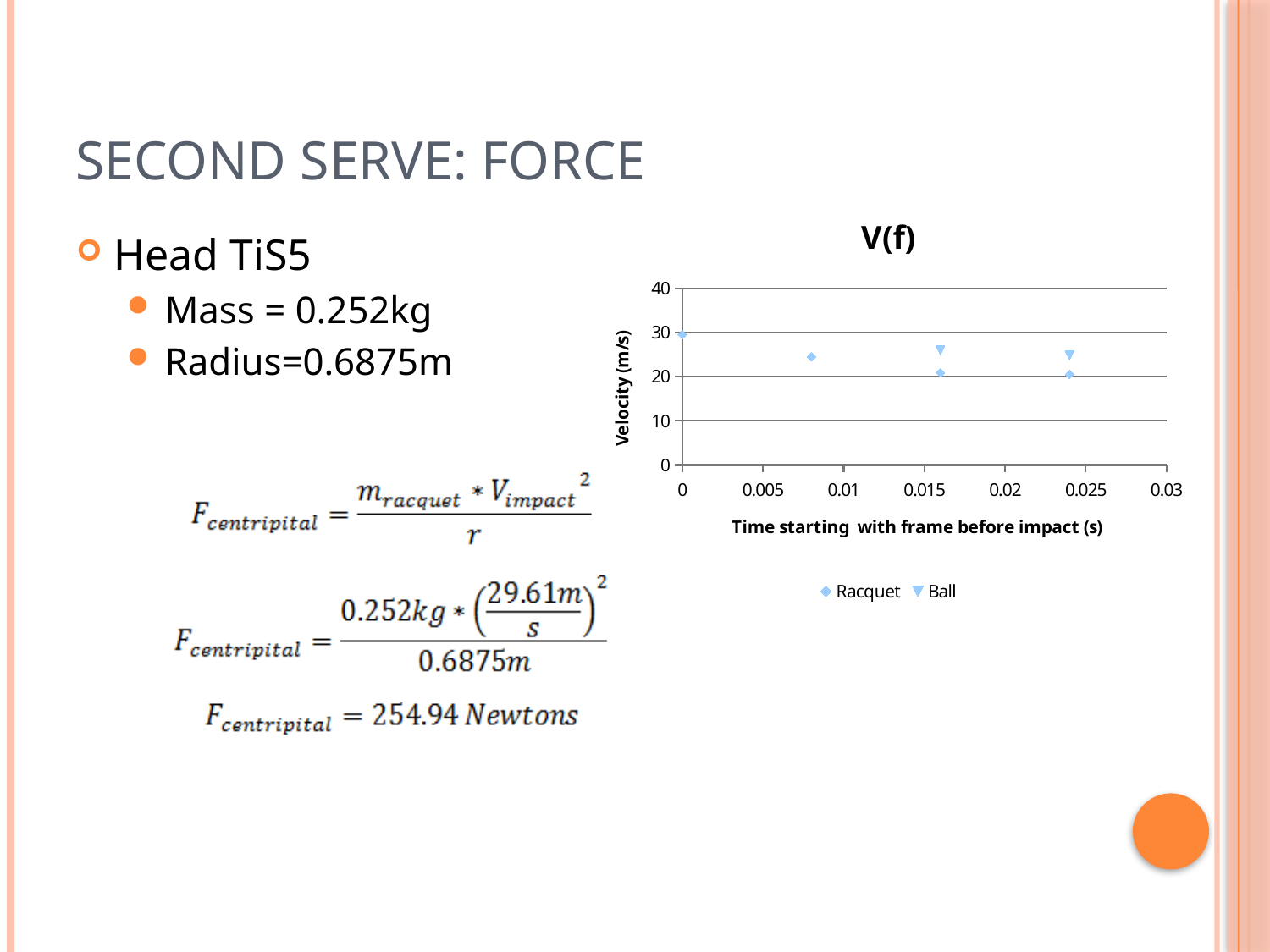
Is the Racquet velocity at time 0.016 s greater or less than 30 m/s? less What is the title of the chart on the slide? V(f) Does the Racquet velocity rise or fall as time increases along the x axis? fall What are the two series named in the legend of the V(f) chart? Racquet and Ball Is the Ball velocity at time 0.016 s greater or less than 20 m/s? greater Is the Racquet velocity at time 0 s greater or less than 40 m/s? less At time 0.024 s, which series has the lower velocity, Racquet or Ball? Racquet What kind of chart is shown on the slide? scatter chart How many series does the legend of the V(f) chart list? 2 At time 0.016 s, which series has the higher velocity, Racquet or Ball? Ball